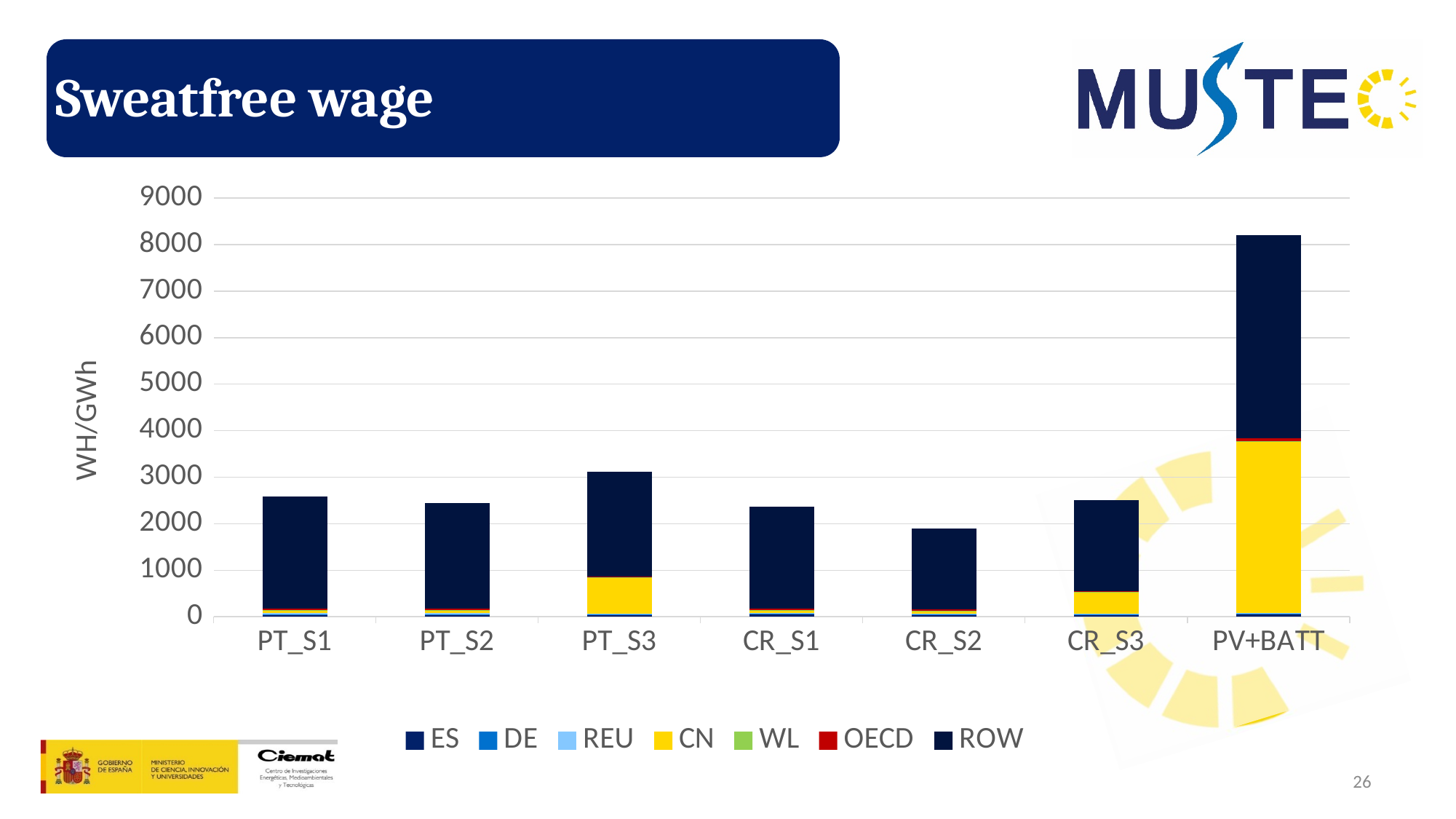
What kind of chart is shown on the slide? stacked bar chart Which category has the highest total bar? PV+BATT Is the total value for PT_S1 greater or less than 2000? greater Is the total value for CR_S2 greater or less than 2500? less What is the label of the y axis? WH/GWh Which category has the lowest total bar? CR_S2 Which series is shown in yellow in the legend? CN How many series does the legend list? 7 Which has the larger total bar, PT_S3 or PT_S2? PT_S3 Is the total value for PT_S3 greater or less than 2500? greater How many categories are shown on the x axis of the chart? 7